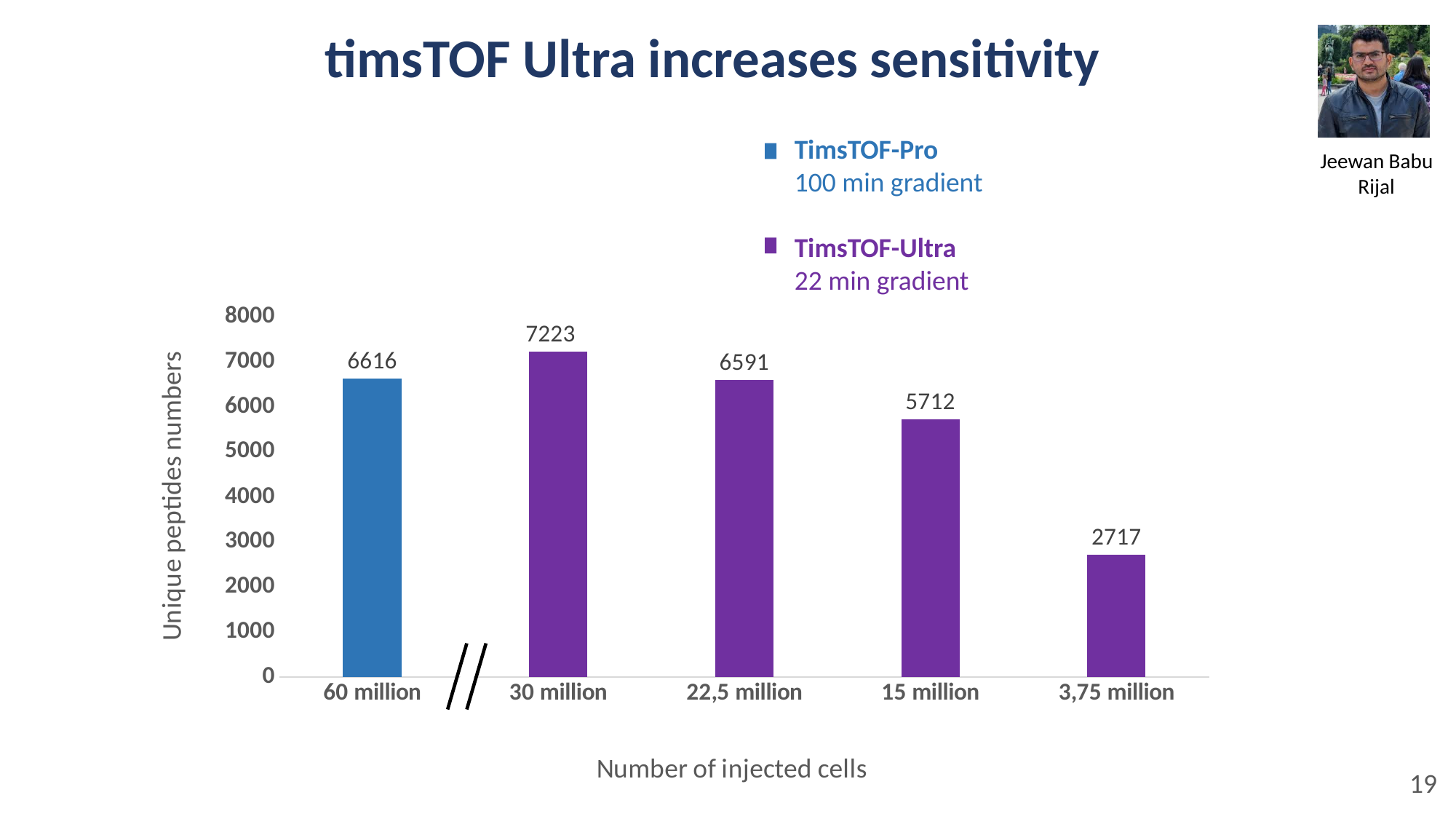
How many series does the legend list? 2 Which has more unique peptides: 22,5 million or 15 million injected cells? 22,5 million Is the value for 15 million injected cells greater or less than 5000? greater What is the number of unique peptides for 3,75 million injected cells? 2717 What is the difference in unique peptides between 30 million and 60 million injected cells? 607 What is the number of unique peptides for 60 million injected cells? 6616 Which number of injected cells gives the lowest number of unique peptides? 3,75 million What type of chart is shown on the slide? Bar chart How many bars are shown in the chart? 5 What is the number of unique peptides for 30 million injected cells? 7223 Which number of injected cells gives the highest number of unique peptides? 30 million What is the difference in unique peptides between 15 million and 3,75 million injected cells? 2995